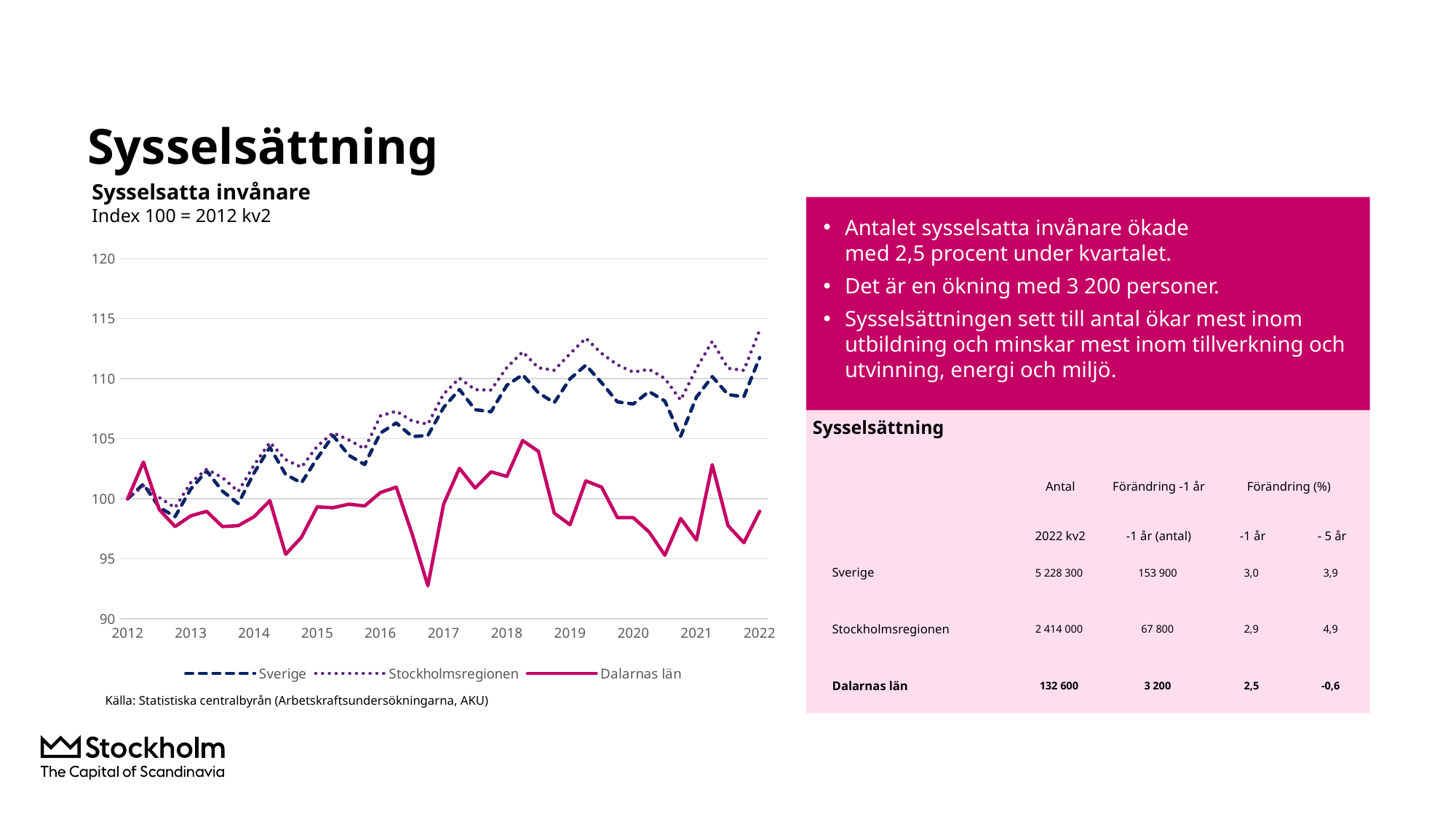
Is the lowest value for Dalarnas län (around late 2016) greater or less than 95? less How many year labels are shown on the x axis? 11 Which series reaches the lowest point anywhere on the chart? Dalarnas län Is the value for Dalarnas län in 2022 greater or less than 105? less How many series does the chart legend list? 3 Is the value for Stockholmsregionen in 2022 greater or less than 110? greater Which series has the lowest value at the end of the chart in 2022? Dalarnas län Which series has the highest value at the end of the chart in 2022? Stockholmsregionen What is the title of the chart? Sysselsatta invånare Does the Stockholmsregionen series generally rise or fall from 2012 to 2022? rise What kind of chart is shown on the slide? Line chart What base period does the index use, according to the chart subtitle? Index 100 = 2012 kv2